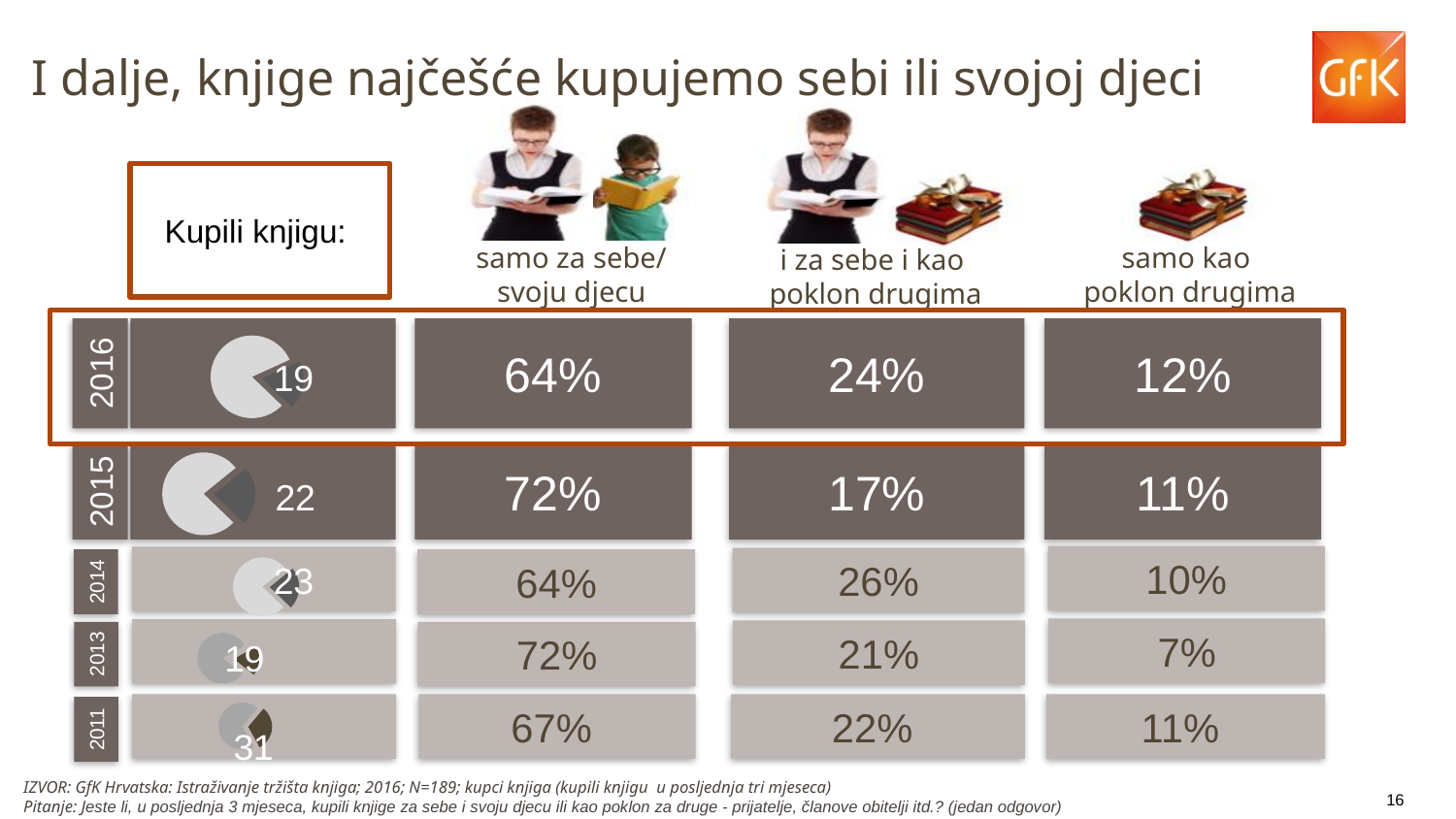
What value is shown in the pie chart for 2015 in the 'Kupili knjigu' column? 22 What percentage is shown for 2016 under 'samo za sebe/svoju djecu'? 64% What is the difference between the 'Kupili knjigu' pie chart values for 2011 and 2016? 12 Which year is highlighted with an orange border on the slide? 2016 How many pie charts are shown in the 'Kupili knjigu' column? 5 What percentage is shown for 2013 under 'samo kao poklon drugima'? 7% Which year's pie chart in the 'Kupili knjigu' column shows the highest value? 2011 What value is shown in the pie chart for 2011 in the 'Kupili knjigu' column? 31 Which is larger, the 'Kupili knjigu' pie chart value for 2015 or for 2016? 2015 What value is shown in the pie chart for 2014 in the 'Kupili knjigu' column? 23 What kind of chart is used in the 'Kupili knjigu' column for each year? Pie chart What value is shown in the pie chart for 2016 in the 'Kupili knjigu' column? 19